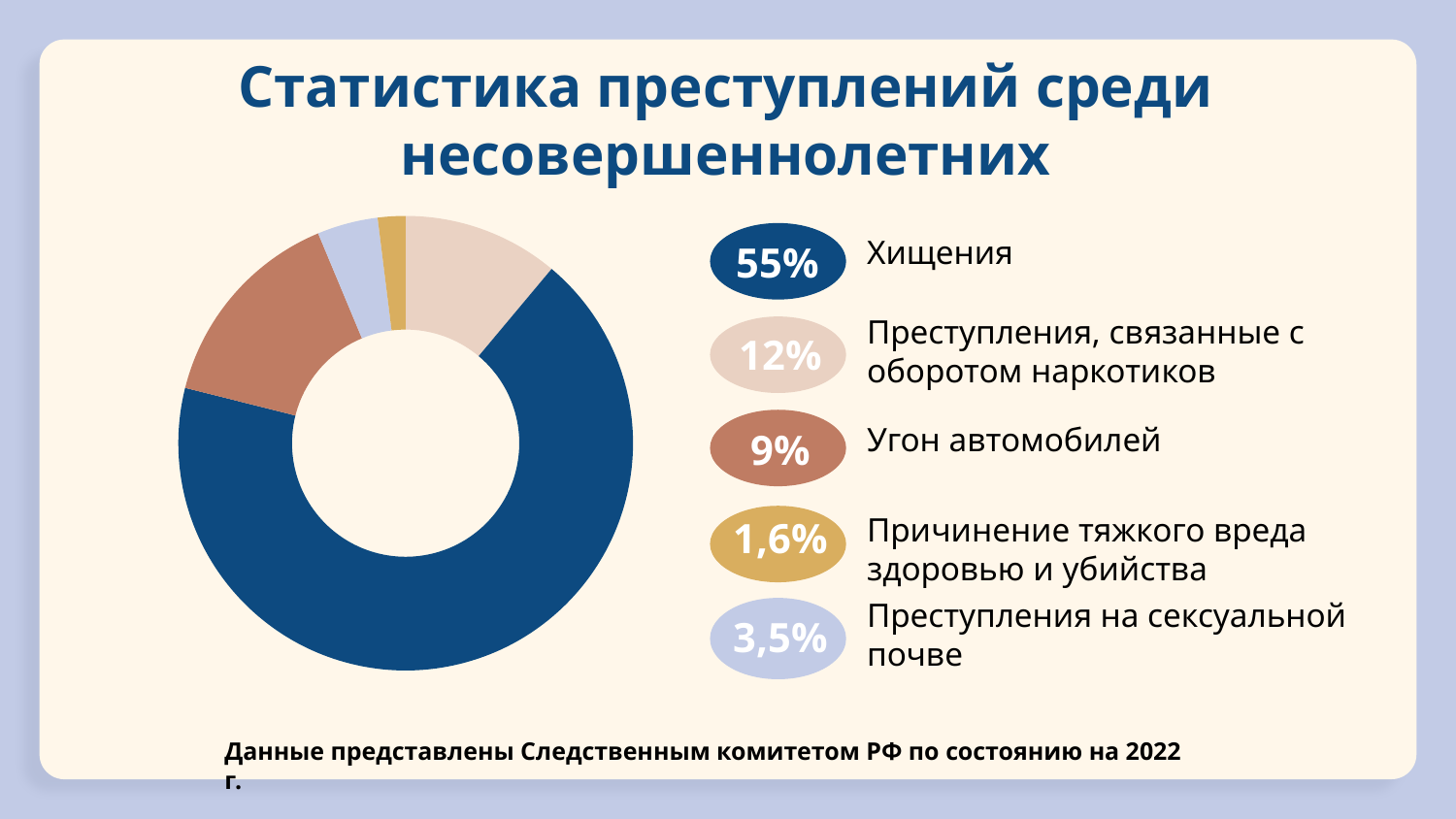
What share is shown for Преступления, связанные с оборотом наркотиков? 12% What share is shown for Преступления на сексуальной почве? 3,5% What share is shown for Хищения? 55% What share is shown for Угон автомобилей? 9% How many categories does the chart show? 5 What colour is the segment for Хищения? Dark blue Which category has the smallest share? Причинение тяжкого вреда здоровью и убийства Which category has the largest share? Хищения What is the difference between the shares for Хищения and Преступления, связанные с оборотом наркотиков? 43% What kind of chart is shown on the slide? Donut (pie) chart What share is shown for Причинение тяжкого вреда здоровью и убийства? 1,6% Which is larger: the share for Угон автомобилей or the share for Преступления на сексуальной почве? Угон автомобилей